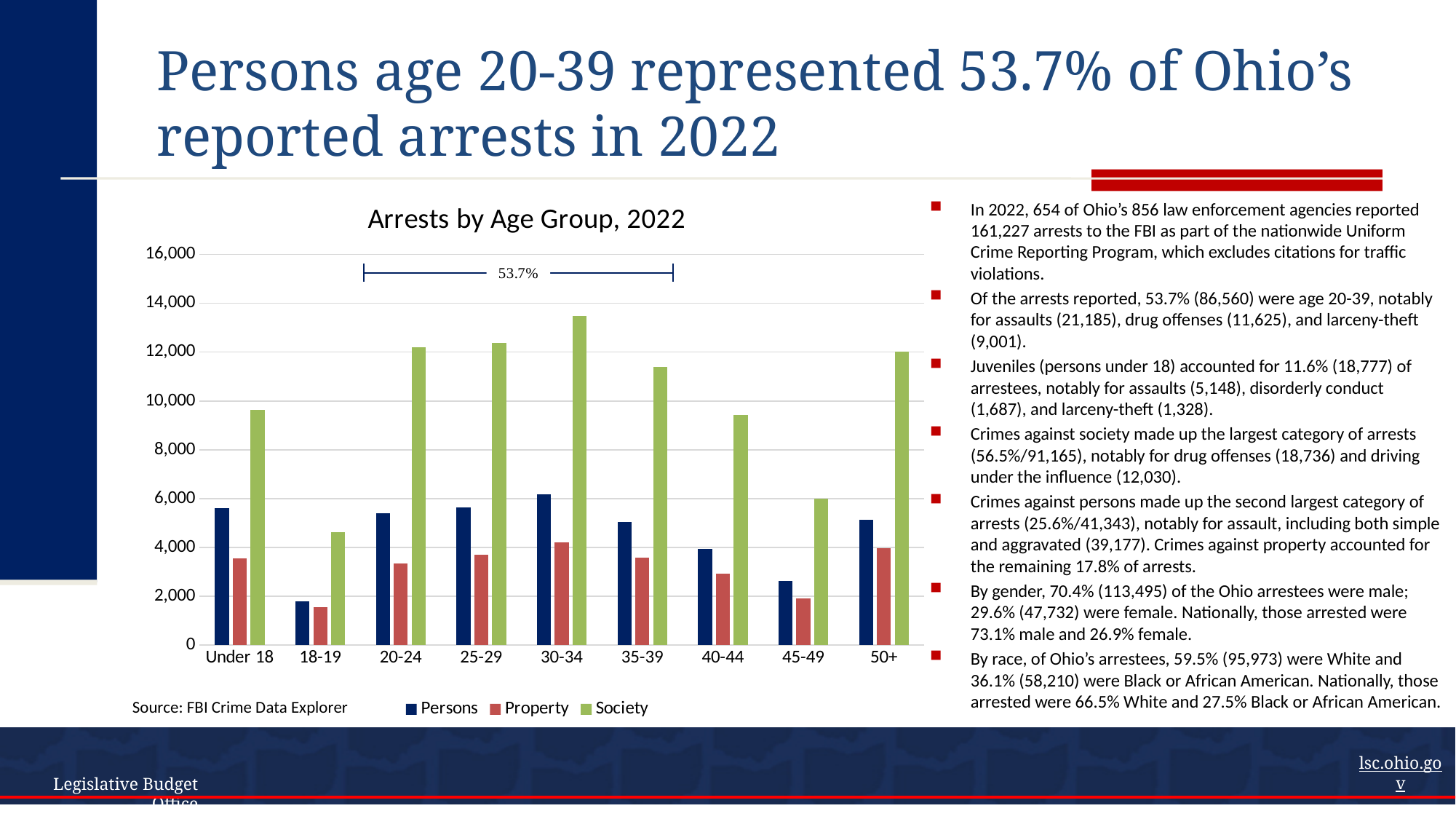
Which age group has the lowest Society value? 18-19 How many age groups are shown on the x axis of the chart? 9 Which age group has the highest Society value? 30-34 Which age group has the lowest Persons value? 18-19 What kind of chart is shown on the slide? bar chart Is the Society value for 30-34 greater or less than 12,000? greater Is the Persons value for 45-49 greater or less than 4,000? less Which is larger, the Persons value for 30-34 or the Persons value for 45-49? 30-34 How many series does the chart legend list? 3 What percentage is shown in the annotation bracket above the 20-24 to 35-39 age groups? 53.7% What is the title of the chart? Arrests by Age Group, 2022 Is the Society value for 18-19 greater or less than 6,000? less